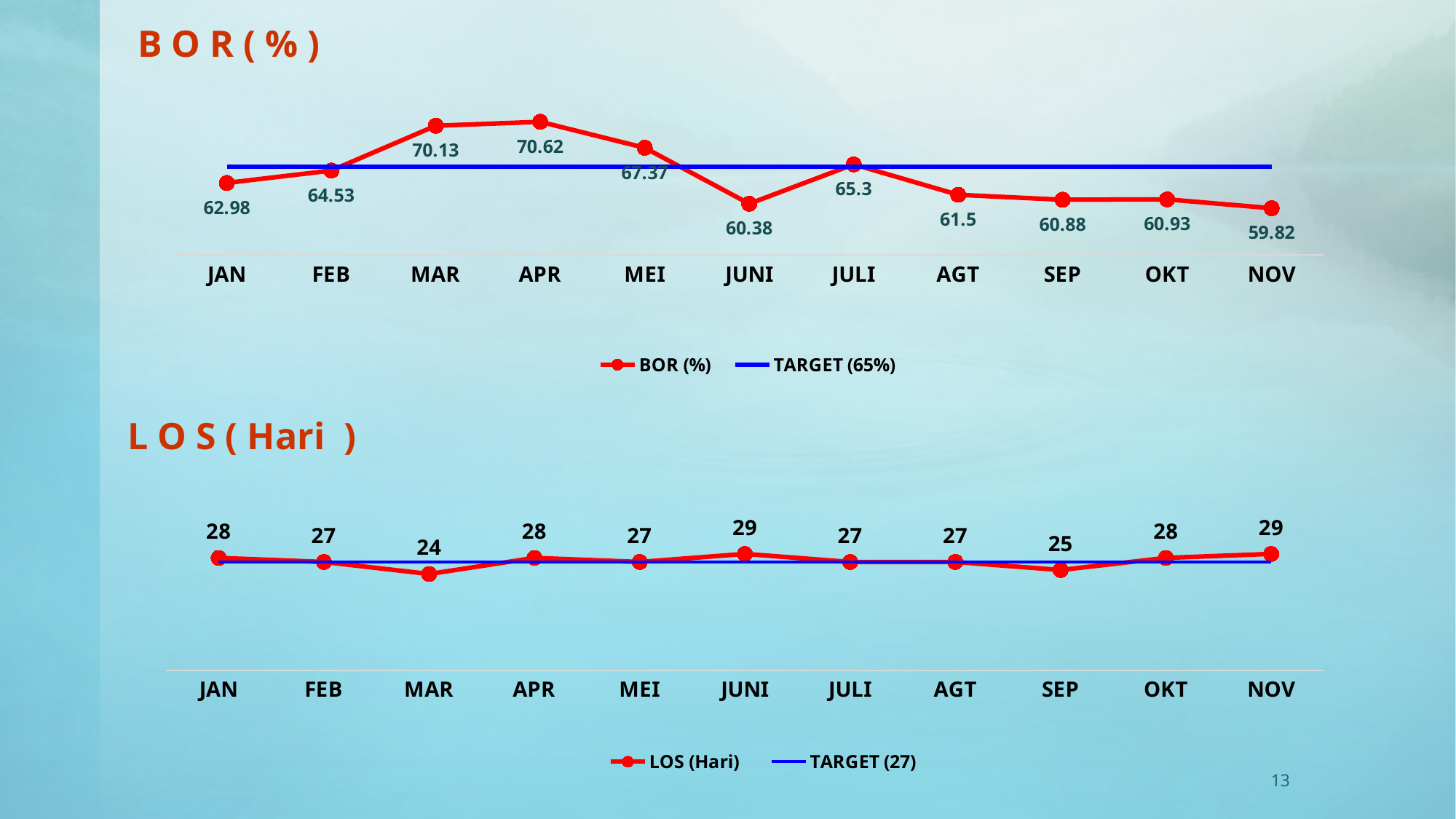
In the BOR (%) chart, how many months are plotted on the x axis? 11 In the LOS (Hari) chart, what is the difference between the LOS values for JUNI and MAR? 5 In the BOR (%) chart, what is the difference between the BOR values for APR and JAN? 7.64 In the BOR (%) chart, what is the BOR value for JUNI? 60.38 In the LOS (Hari) chart, which month has the lowest LOS value? MAR In the BOR (%) chart, how many series does the legend list? 2 In the BOR (%) chart, what is the BOR value for APR? 70.62 In the BOR (%) chart, which is larger, the BOR value for MAR or for MEI? MAR In the LOS (Hari) chart, what is the LOS value for MAR? 24 In the BOR (%) chart, which month has the highest BOR value? APR In the BOR (%) chart, which month has the lowest BOR value? NOV What type of chart is the LOS (Hari) chart? Line chart